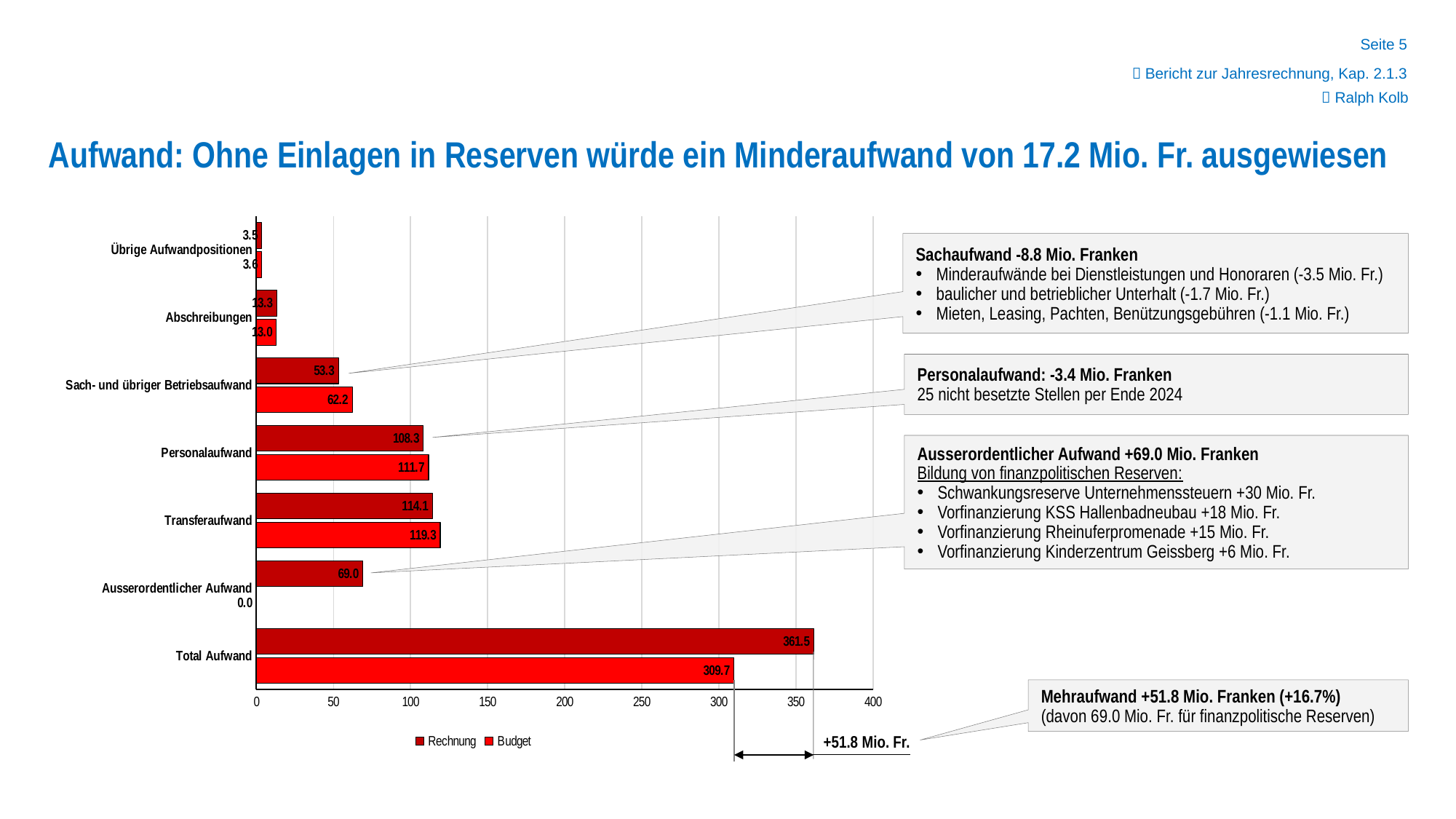
For Transferaufwand, which is larger: the Rechnung value or the Budget value? Budget What kind of chart is shown on the slide? bar chart Which category has the lowest Budget value? Ausserordentlicher Aufwand How many categories are shown on the chart's vertical axis? 7 What is the Rechnung value for Personalaufwand? 108.3 What is the Budget value for Total Aufwand? 309.7 What is the Budget value for Ausserordentlicher Aufwand? 0.0 What is the Rechnung value for Total Aufwand? 361.5 How many series does the chart legend list? 2 Which category has the highest Rechnung value? Total Aufwand What is the difference between the Rechnung and Budget values for Total Aufwand? 51.8 What is the Budget value for Sach- und übriger Betriebsaufwand? 62.2